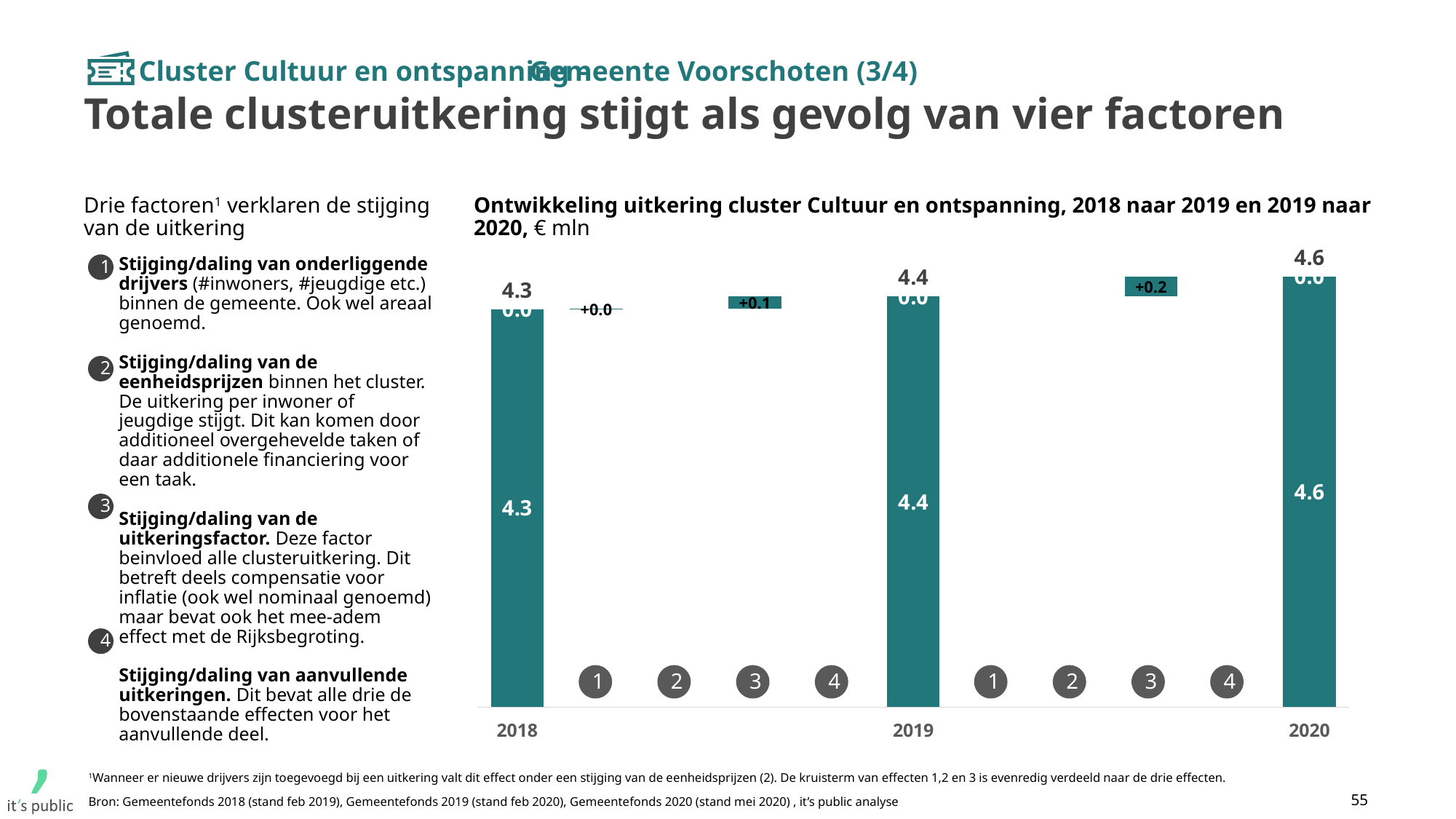
What is the total uitkering for 2020 in the chart? 4.6 Which year has the highest total uitkering in the chart? 2020 What is the total uitkering for 2019 in the chart? 4.4 What is the effect of factor 3 from 2018 to 2019 in the chart? +0.1 What is the effect of factor 3 from 2019 to 2020 in the chart? +0.2 Which year has the lowest total uitkering in the chart? 2018 What is the effect of factor 1 from 2018 to 2019 in the chart? +0.0 Do the yearly totals rise or fall from 2018 to 2020 in the chart? rise What is the difference between the 2020 total and the 2018 total in the chart? 0.3 In what unit are the values in the chart expressed? € mln Which is larger in the chart, the 2019 total or the 2018 total? 2019 What is the total uitkering for 2018 in the chart? 4.3